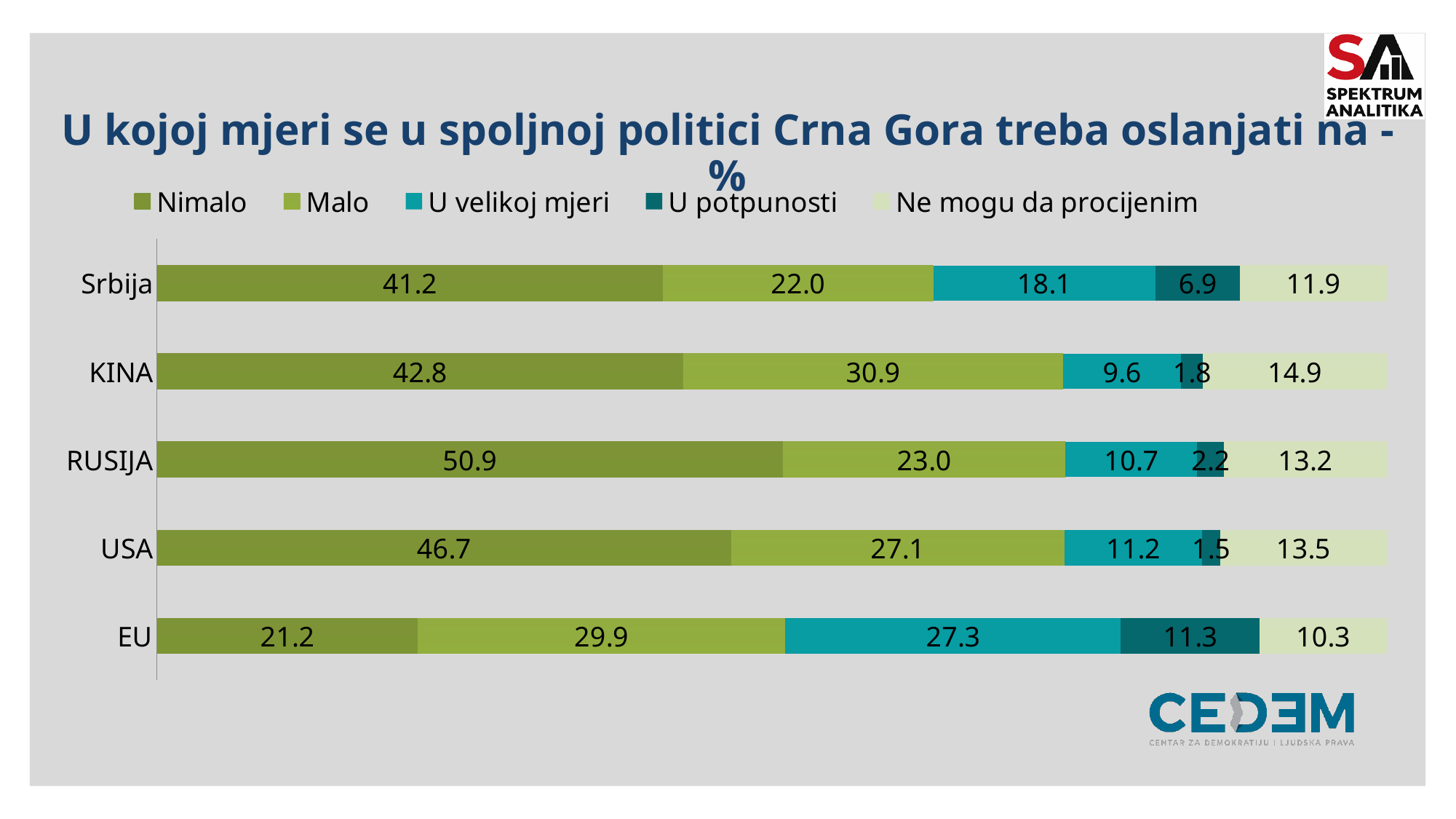
What is the total of the stacked bar for KINA? 100.0 How many categories are plotted on the chart? 5 How many series does the legend list? 5 Which is larger: the 'U potpunosti' value for EU or for Srbija? EU What is the 'Nimalo' value for RUSIJA? 50.9 Which legend entry is shown in the lightest green colour? Ne mogu da procijenim What is the 'Ne mogu da procijenim' value for KINA? 14.9 What kind of chart is shown on the slide? Stacked bar chart Which category has the lowest 'U potpunosti' value? USA What is the difference between the 'Malo' values for KINA and Srbija? 8.9 What is the 'U velikoj mjeri' value for EU? 27.3 Which category has the highest 'Nimalo' value? RUSIJA